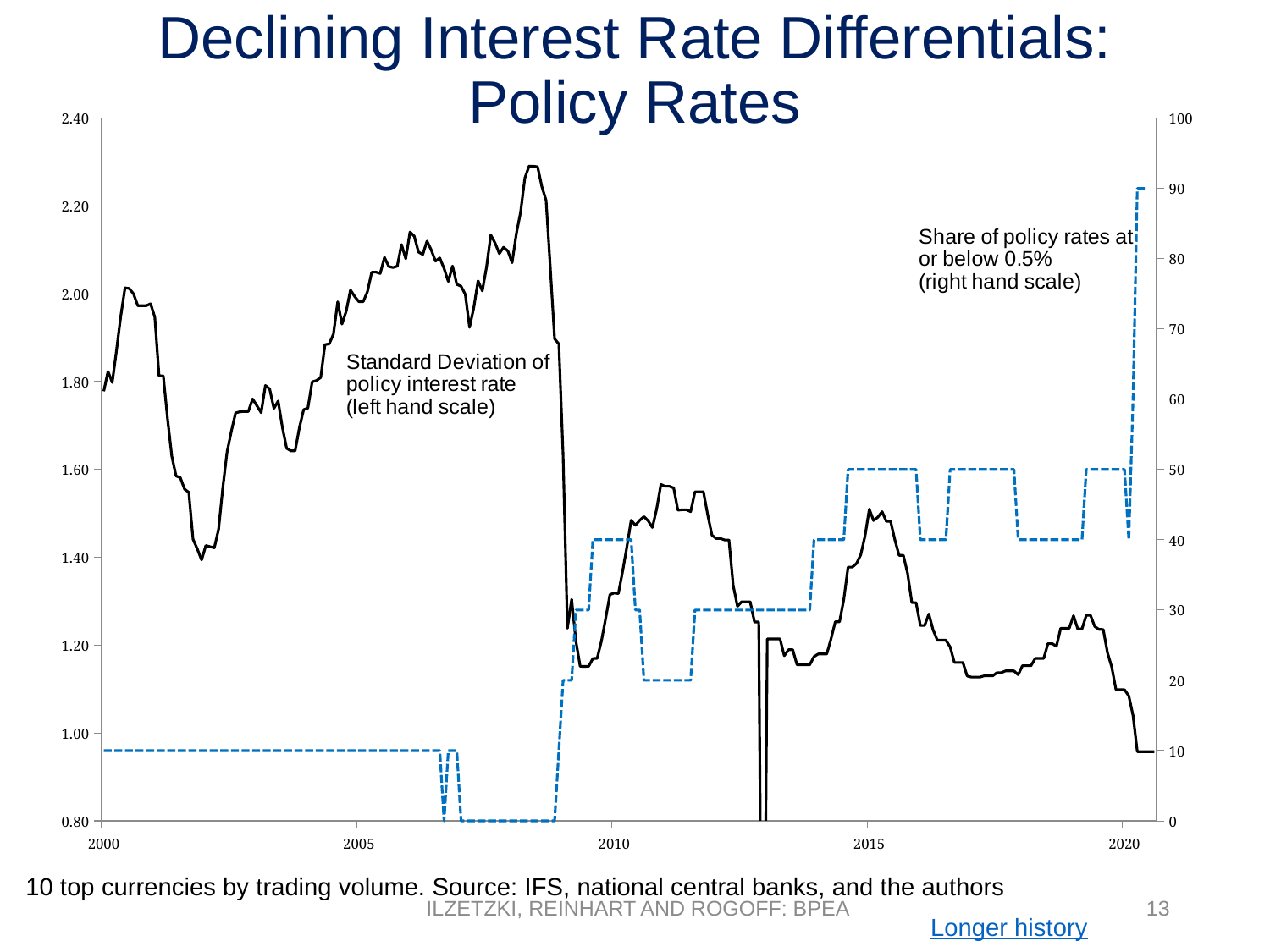
Is the share of policy rates at or below 0.5% at the end of the series in 2020 greater or less than 80? greater What kind of chart is shown on the slide? line chart What is the share of policy rates at or below 0.5% in 2015? 50 What is the title of the chart on the slide? Declining Interest Rate Differentials: Policy Rates Is the peak value of the standard deviation of policy interest rate, reached around 2008, greater or less than 2.20? greater How many data series are plotted on the chart? 2 Is the share of policy rates at or below 0.5% in 2008 greater or less than 10? less Overall, does the standard deviation of policy interest rate rise or fall between 2000 and 2020? fall What is the share of policy rates at or below 0.5% in 2000? 10 Which series is plotted against the right hand scale? Share of policy rates at or below 0.5% Overall, does the share of policy rates at or below 0.5% rise or fall between 2000 and 2020? rise